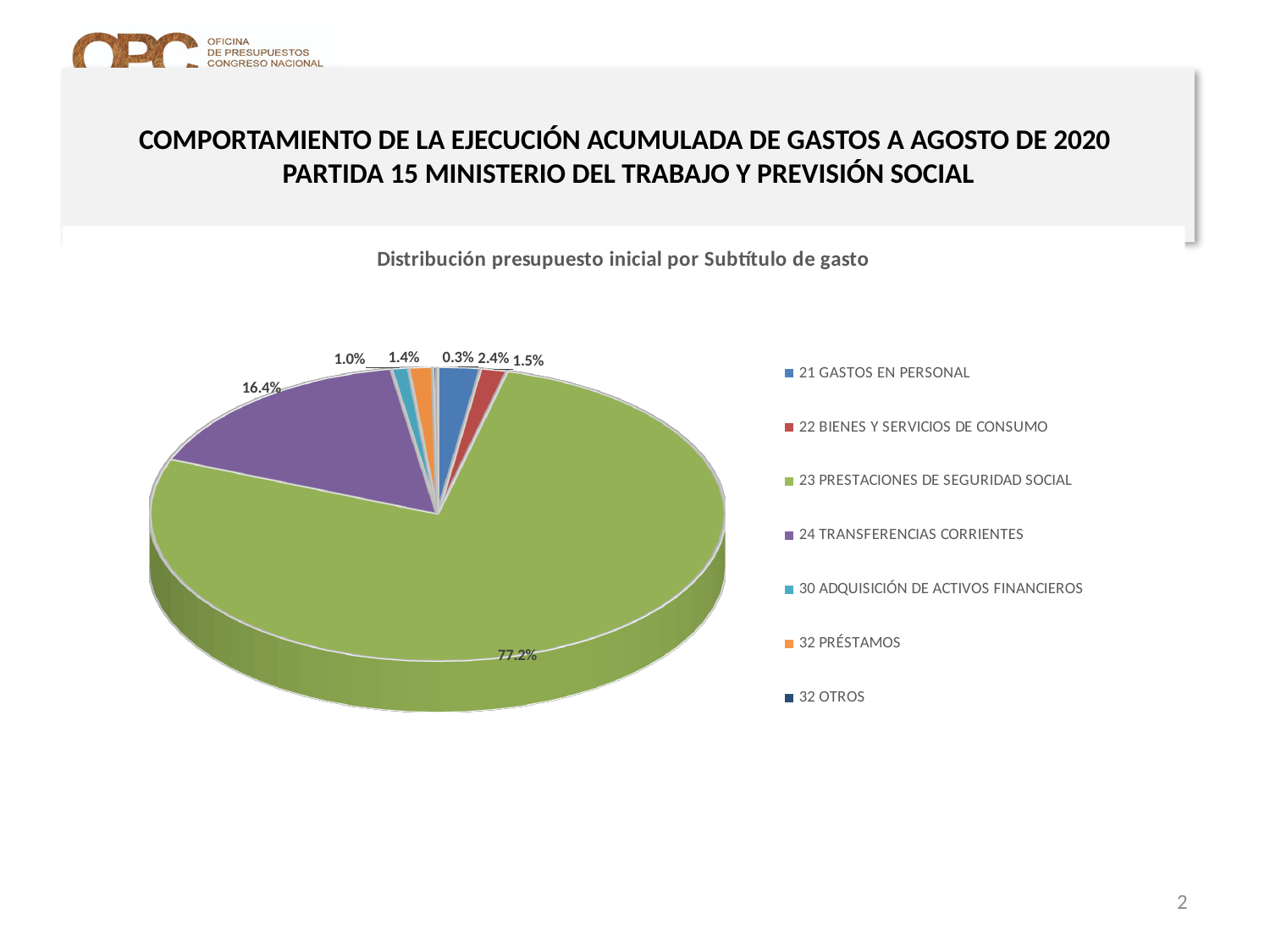
What share of the pie does 23 PRESTACIONES DE SEGURIDAD SOCIAL represent? 77.2% How many categories does the legend list? 7 What type of chart is shown on the slide? pie chart What share of the pie does 24 TRANSFERENCIAS CORRIENTES represent? 16.4% Which category has the largest slice of the pie? 23 PRESTACIONES DE SEGURIDAD SOCIAL What is the smallest percentage label shown on the pie? 0.3% What is the title of the chart? Distribución presupuesto inicial por Subtítulo de gasto Which is larger, the slice for 24 TRANSFERENCIAS CORRIENTES or the slice for 21 GASTOS EN PERSONAL? 24 TRANSFERENCIAS CORRIENTES What is the difference in percentage points between 23 PRESTACIONES DE SEGURIDAD SOCIAL and 24 TRANSFERENCIAS CORRIENTES? 60.8 What colour is the slice for 23 PRESTACIONES DE SEGURIDAD SOCIAL? green What share of the pie does 21 GASTOS EN PERSONAL represent? 2.4%